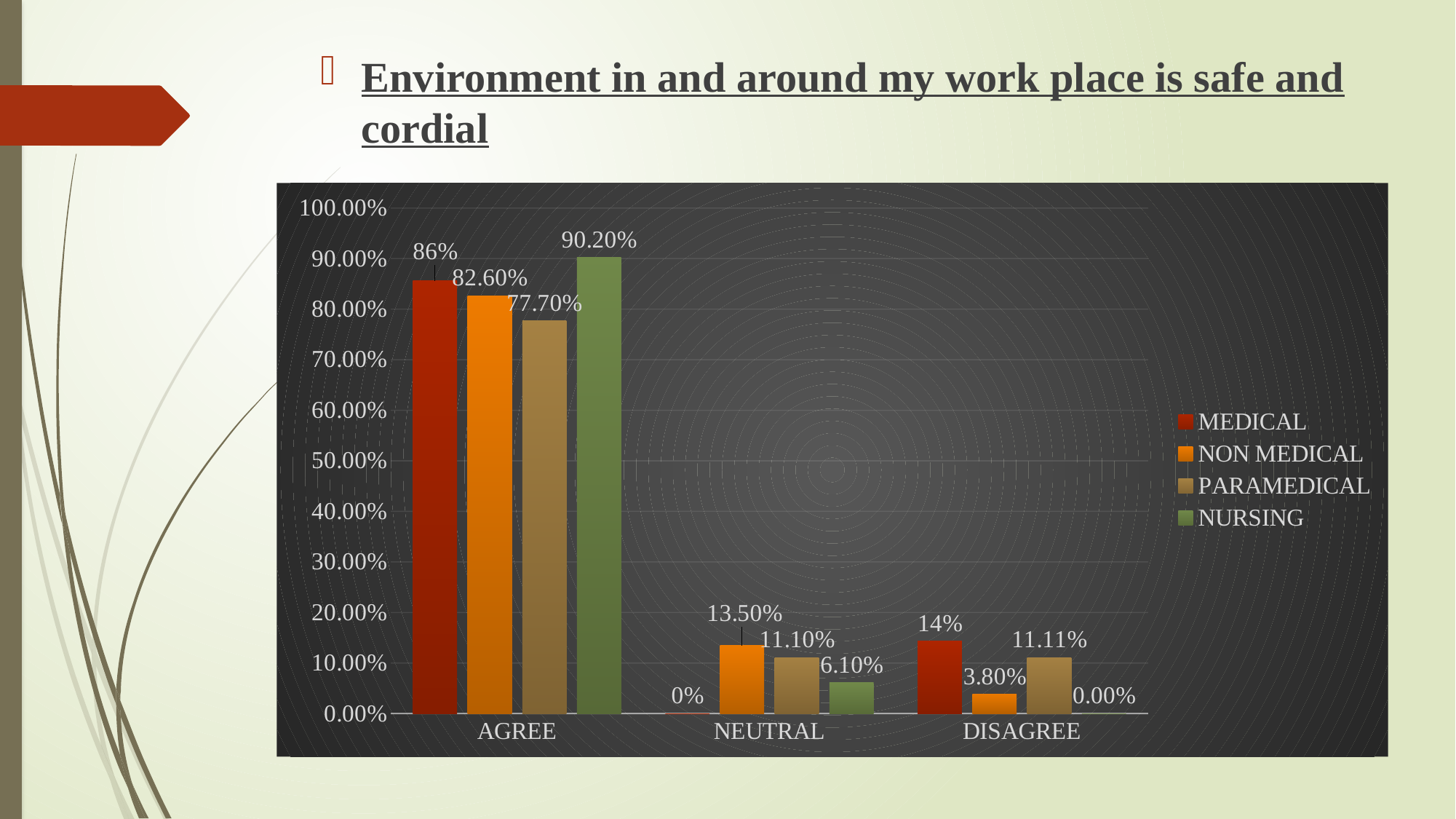
Which series has the highest value in the AGREE category? NURSING Which series is shown in green in the legend? NURSING What kind of chart is shown on the slide? Bar chart What is the value for MEDICAL in the NEUTRAL category? 0% How many series does the legend list? 4 How many categories are shown on the x axis? 3 Which is larger in the DISAGREE category, MEDICAL or NON MEDICAL? MEDICAL What is the value for PARAMEDICAL in the DISAGREE category? 11.11% What is the value for NON MEDICAL in the NEUTRAL category? 13.50% What is the difference between the MEDICAL and PARAMEDICAL values in the AGREE category? 8.30% Which series has the lowest value in the DISAGREE category? NURSING What is the value for NURSING in the AGREE category? 90.20%